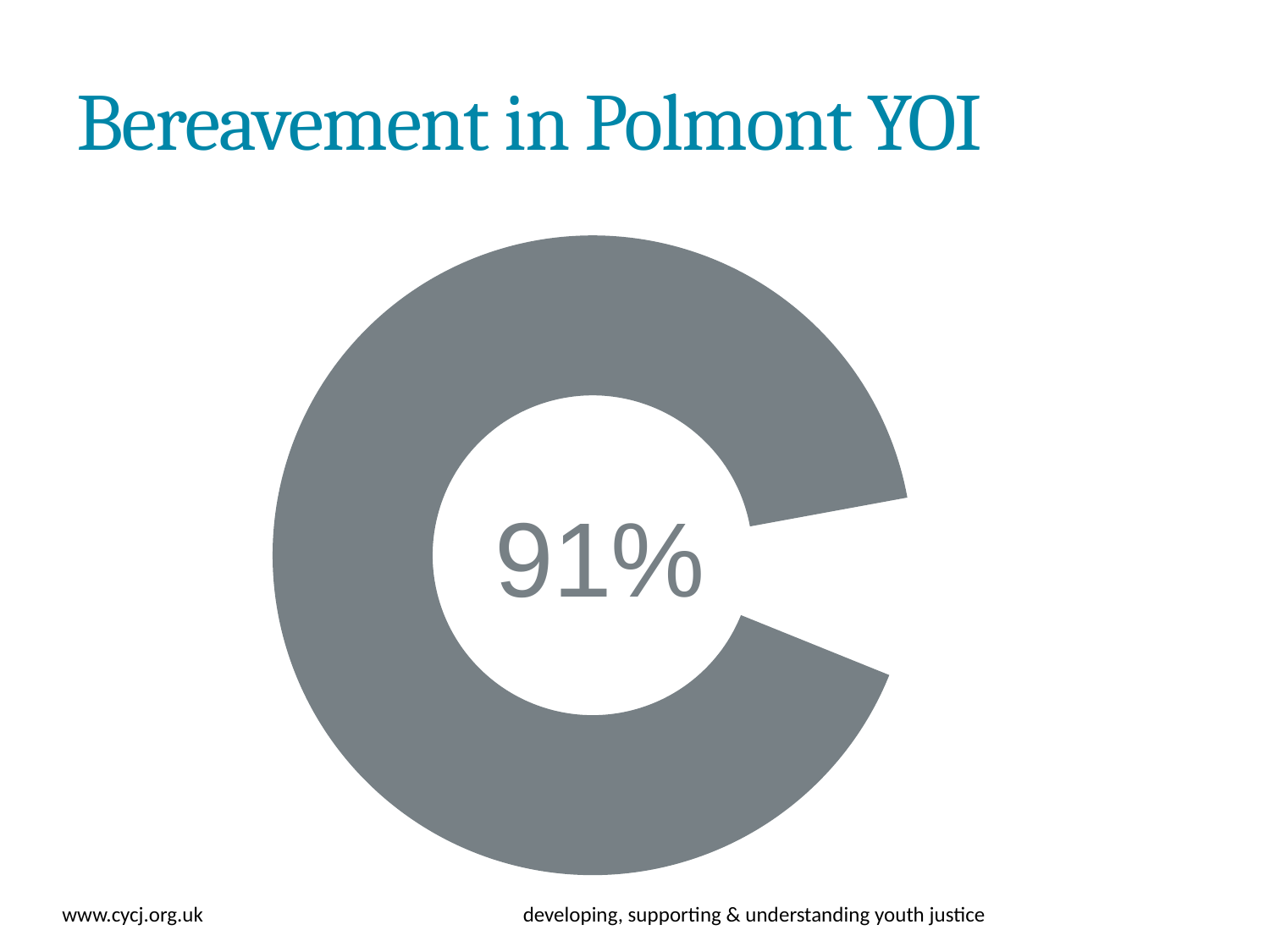
What share of the doughnut chart does the grey segment represent? 91% What kind of chart is shown on the slide? Doughnut chart What colour is the filled segment of the doughnut chart? Grey Is the value shown on the doughnut chart greater or less than 50%? greater What is the title of the slide containing the chart? Bereavement in Polmont YOI What percentage is shown in the centre of the doughnut chart? 91%